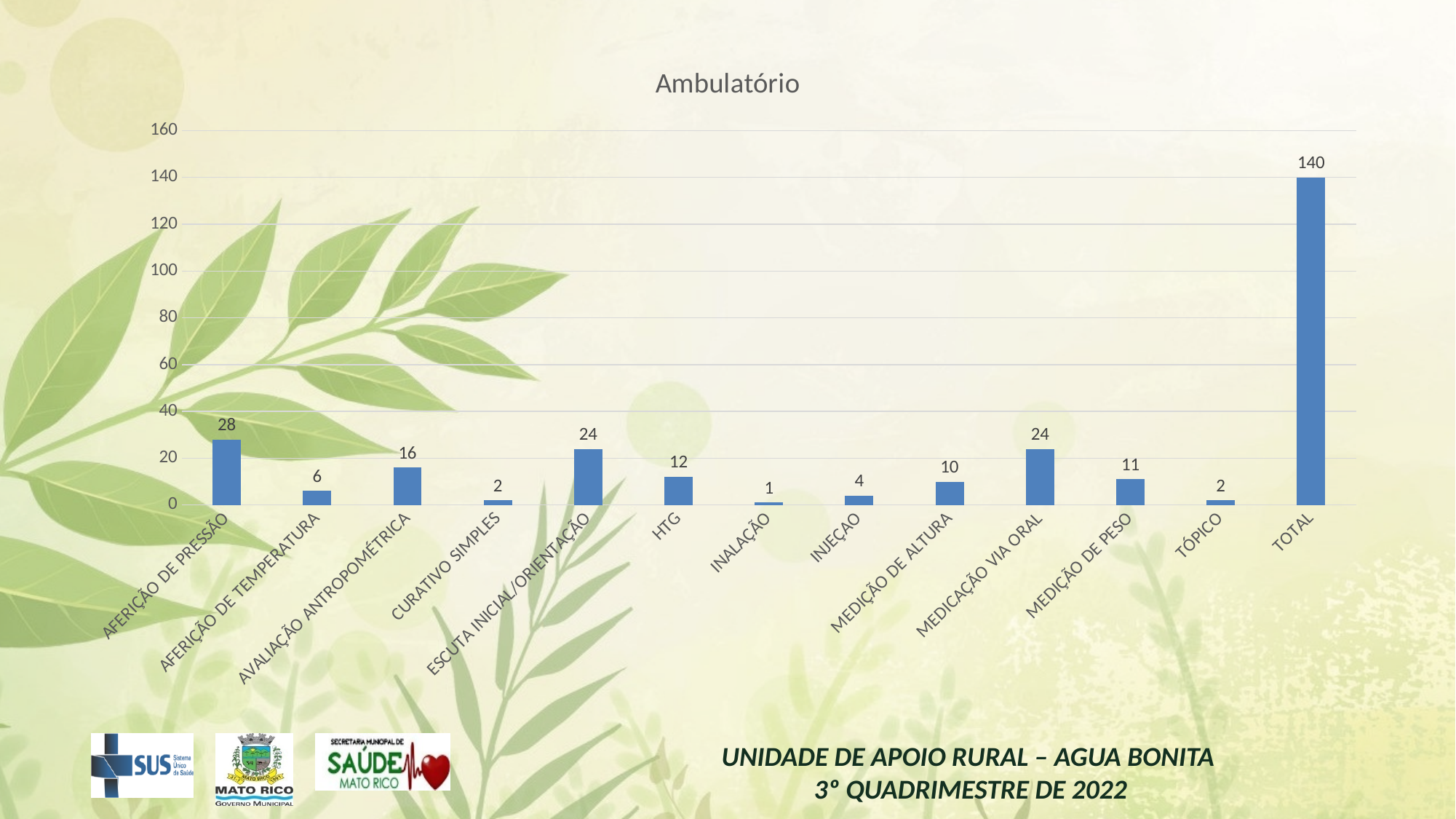
Excluding the TOTAL bar, which category has the highest value? AFERIÇÃO DE PRESSÃO What kind of chart is shown on the slide? bar chart Which category has the lowest value? INALAÇÃO What is the difference between AFERIÇÃO DE PRESSÃO and AVALIAÇÃO ANTROPOMÉTRICA? 12 How many categories are shown on the x axis, including TOTAL? 13 What is the value for AFERIÇÃO DE PRESSÃO? 28 What is the value for MEDICAÇÃO VIA ORAL? 24 Is the value for TOTAL greater or less than 120? greater What is the value for the TOTAL bar? 140 What is the value for HTG? 12 What is the title of the chart? Ambulatório Which is larger, MEDIÇÃO DE PESO or MEDIÇÃO DE ALTURA? MEDIÇÃO DE PESO